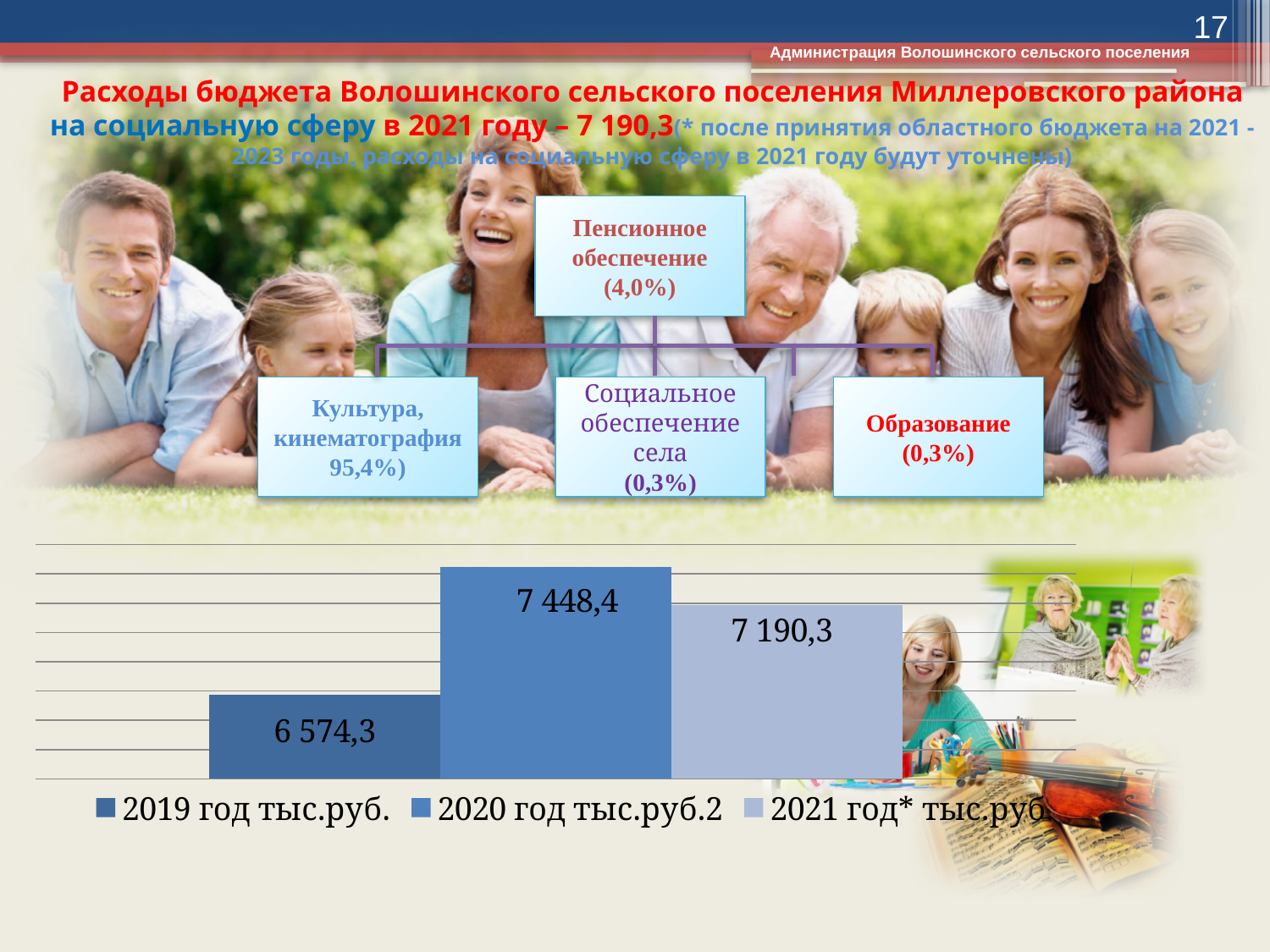
Which year has the highest value in the bar chart? 2020 год What is the difference between the 2020 год and 2021 год* values in the bar chart? 258,1 How many series does the legend of the bar chart list? 3 Which is larger in the bar chart, the value for 2021 год* or the value for 2019 год? 2021 год* What is the value for 2020 год in the bar chart? 7 448,4 In the diagram above the bar chart, what share is shown for Культура, кинематография? 95,4% What type of chart is shown at the bottom of the slide? bar chart What is the value for 2019 год in the bar chart? 6 574,3 Which year has the lowest value in the bar chart? 2019 год What is the value for 2021 год* in the bar chart? 7 190,3 What is the difference between the 2020 год and 2019 год values in the bar chart? 874,1 How many bars are plotted in the bar chart? 3